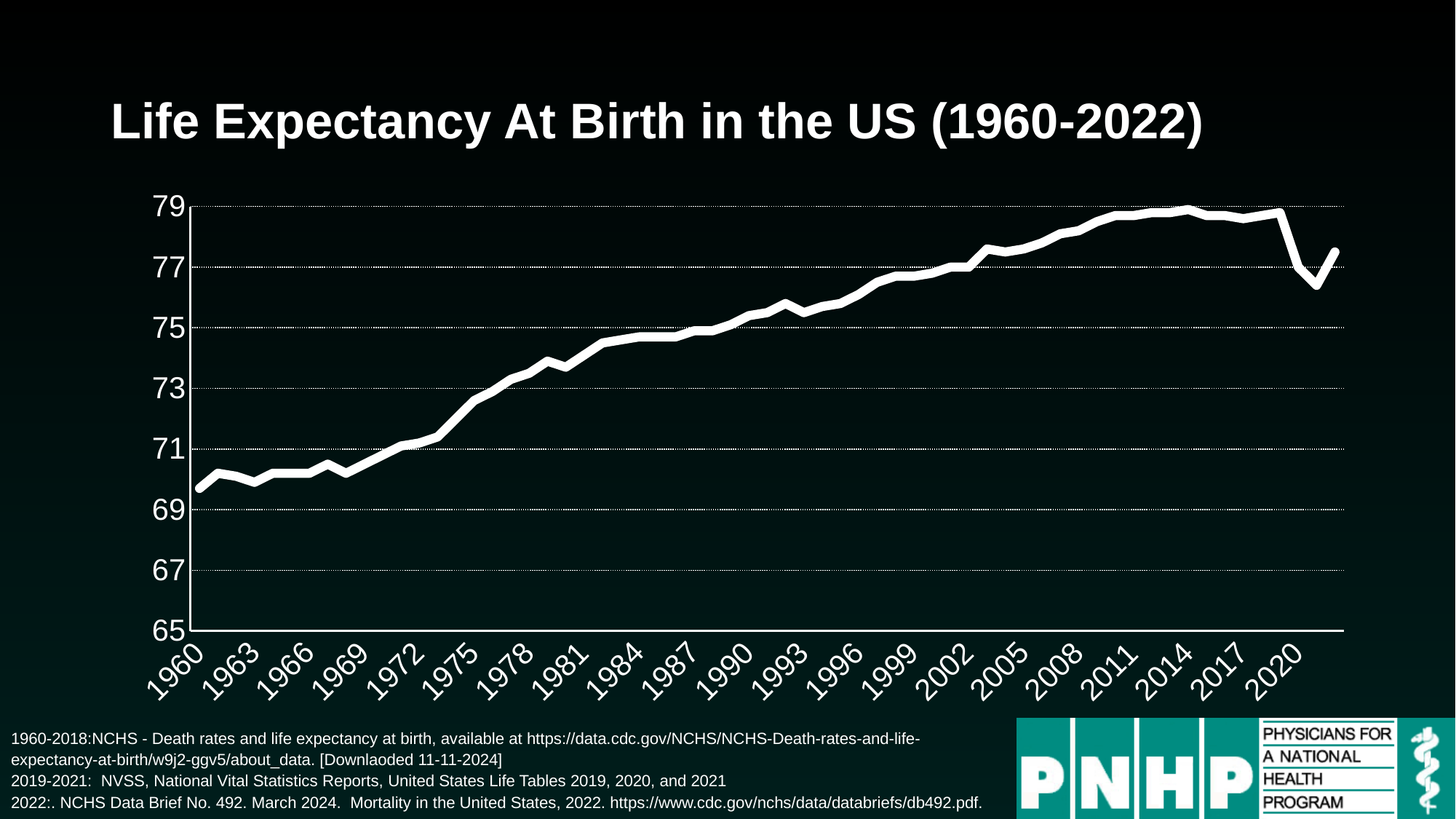
Which year has the higher life expectancy, 1960 or 2014? 2014 What is the title of the chart? Life Expectancy At Birth in the US (1960-2022) Which year has the higher life expectancy, 1972 or 1978? 1978 Is the value for 1960 greater or less than 71? less Is the value for 2014 greater or less than 77? greater Is the value for 1990 greater or less than 75? greater What kind of chart is shown on the slide? line chart What is the highest value shown on the y axis? 79 Overall, does life expectancy rise or fall from 1960 to 2022? rise